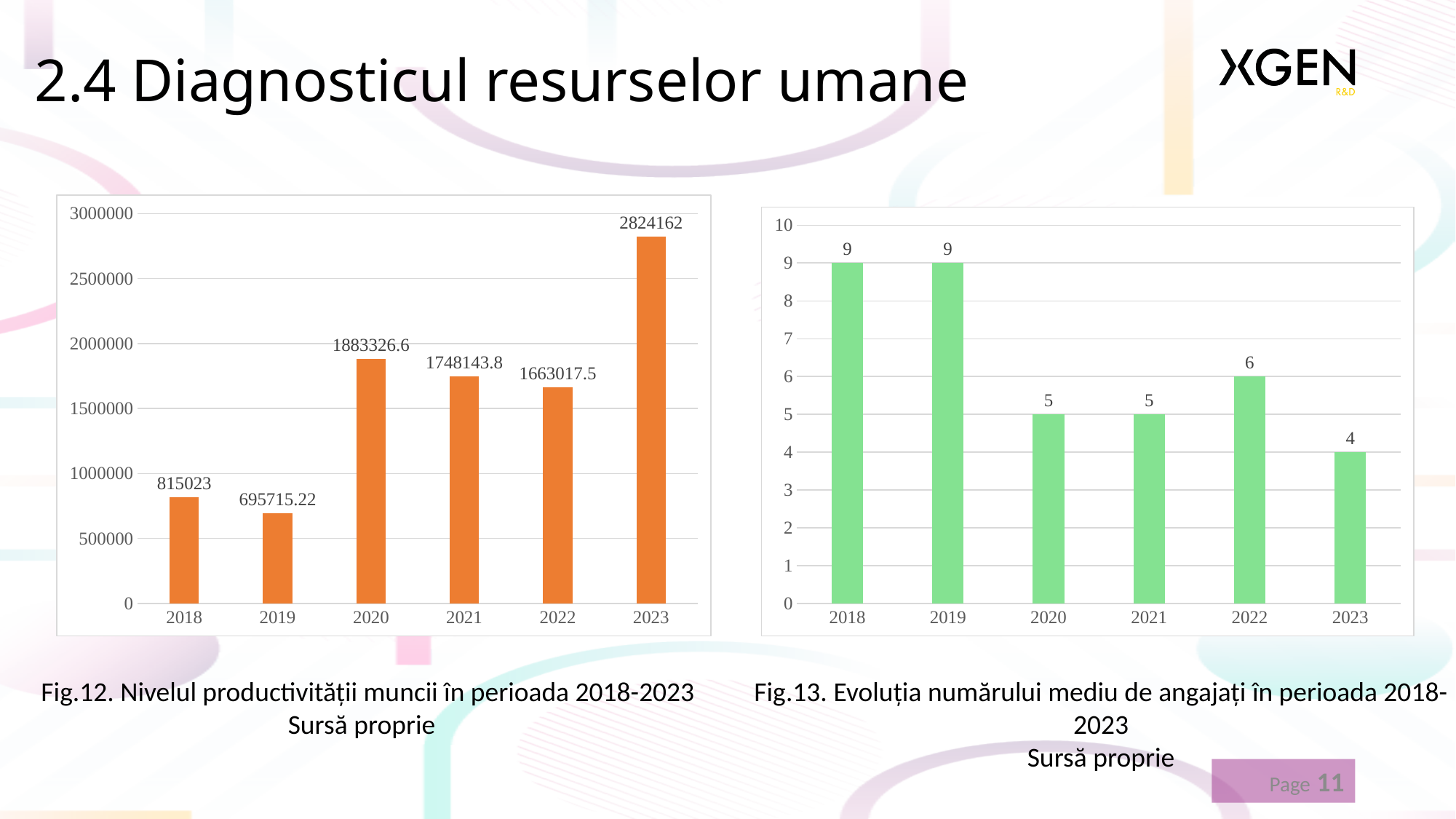
How many years are shown on the x axis of the right chart (Fig.13)? 6 In the right chart (Fig.13), which year has the lowest value? 2023 In the left chart (Fig.12), what is the value for 2019? 695715.22 In the right chart (Fig.13), what is the value for 2022? 6 In the right chart (Fig.13), which is larger, the value for 2021 or the value for 2022? 2022 In the right chart (Fig.13), what is the difference between the values for 2018 and 2023? 5 What type of chart is the left chart (Fig.12)? Bar chart In the left chart (Fig.12), is the value for 2020 greater or less than 1500000? greater In the left chart (Fig.12), what is the difference between the values for 2023 and 2018? 2009139 In the left chart (Fig.12), what is the value for 2023? 2824162 In the left chart (Fig.12), which year has the lowest value? 2019 In the left chart (Fig.12), which year has the highest value? 2023